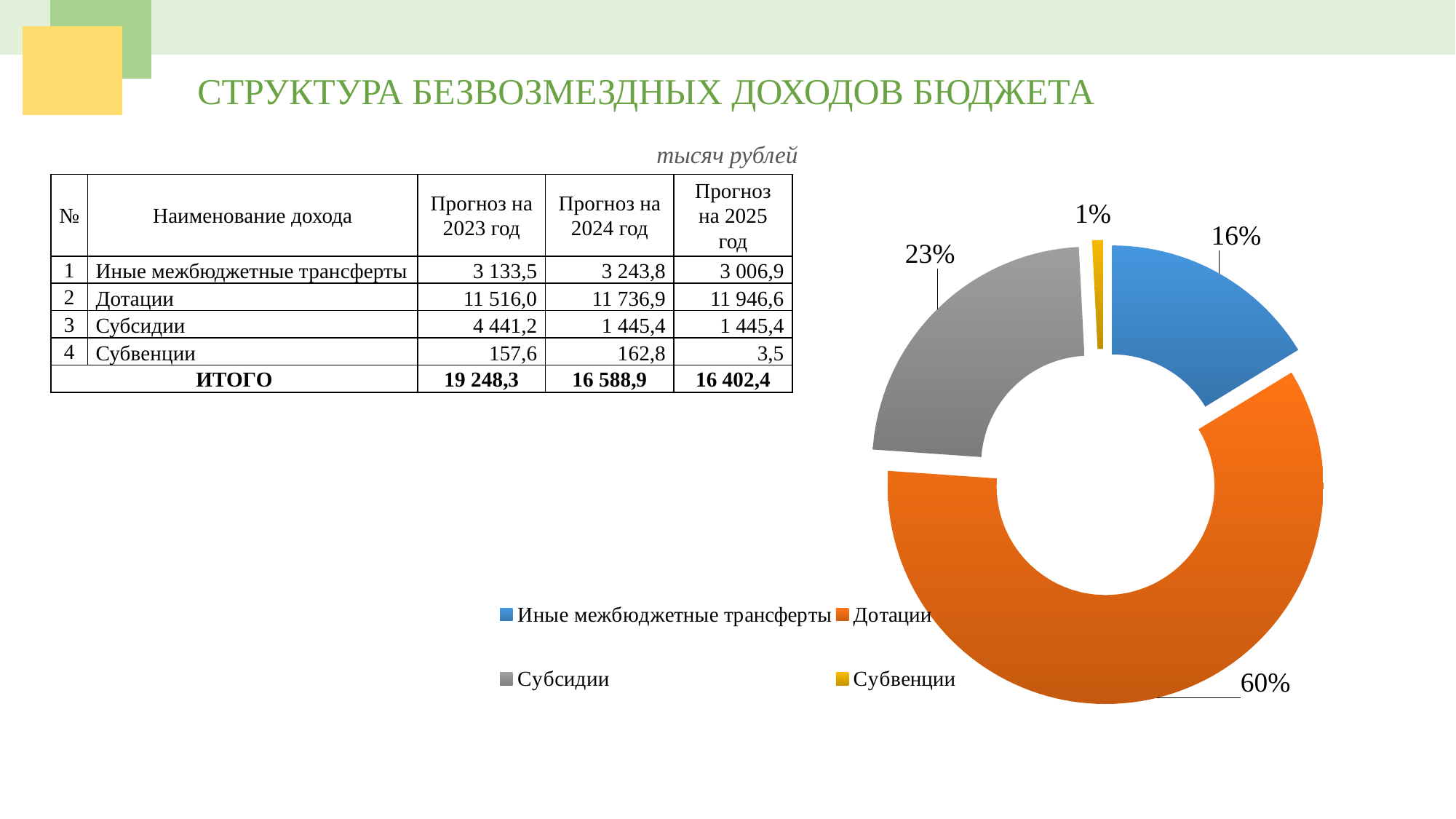
What colour is the Дотации slice in the doughnut chart? Orange What share of the doughnut chart does Субсидии account for? 23% What share of the doughnut chart does Субвенции account for? 1% What kind of chart is shown on the slide? Doughnut (pie) chart How many categories does the legend of the doughnut chart list? 4 What share of the doughnut chart does Дотации account for? 60% Which category has the largest slice in the doughnut chart? Дотации Which category has the smallest slice in the doughnut chart? Субвенции What is the difference in percentage points between the Дотации slice and the Субсидии slice? 37 percentage points How many slices does the doughnut chart have? 4 Which slice is larger in the doughnut chart, Субсидии or Иные межбюджетные трансферты? Субсидии